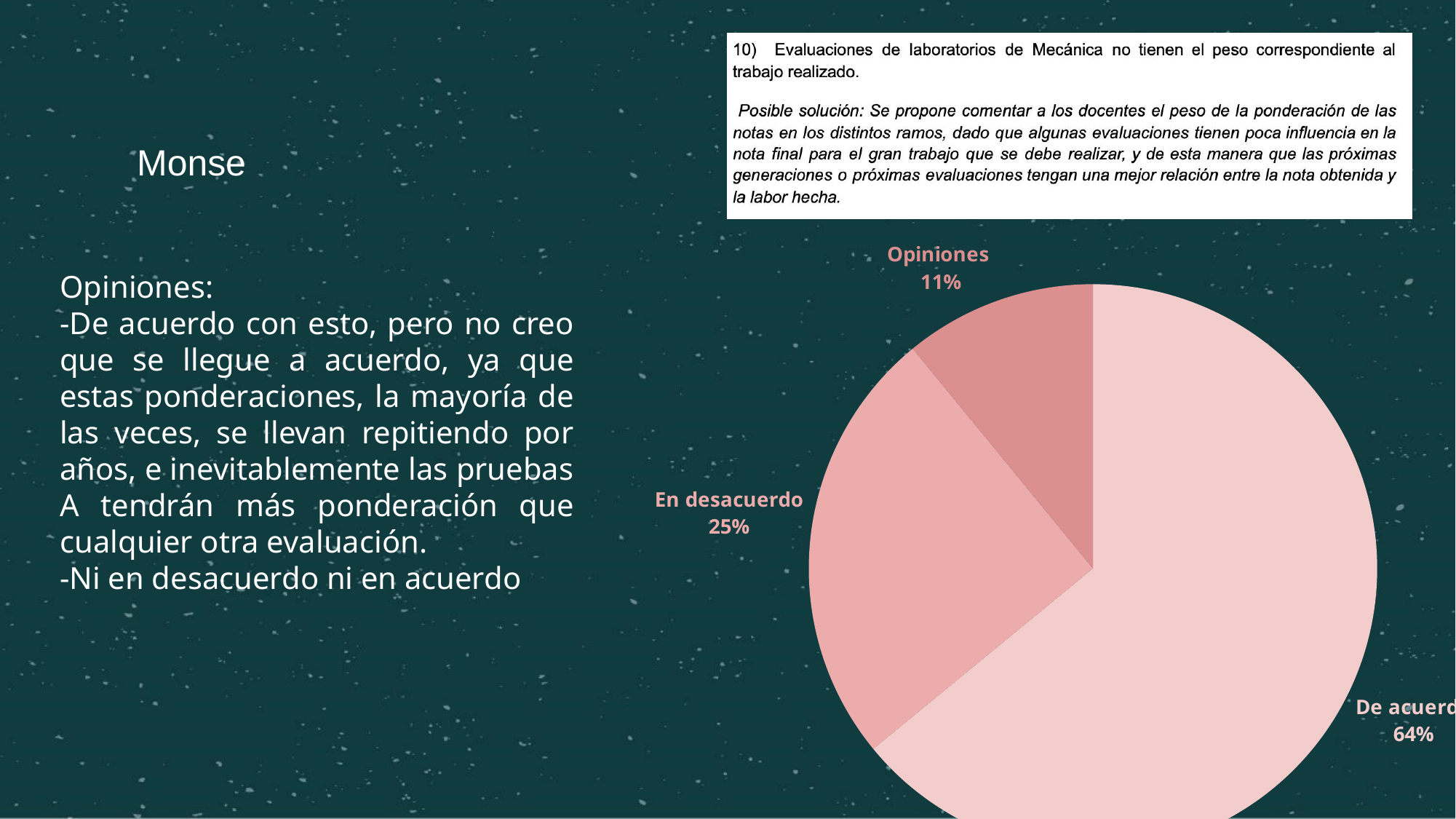
What is the difference in percentage points between the "En desacuerdo" and "Opiniones" slices? 14 What kind of chart is shown on the slide? pie chart What is the difference in percentage points between the "De acuerdo" and "En desacuerdo" slices? 39 Is the "De acuerdo" slice more or less than half of the pie? more Which slice of the pie chart is the smallest? Opiniones What percentage of the pie chart is labelled "En desacuerdo"? 25% How many slices does the pie chart have? 3 What share of the pie does the "De acuerdo" slice represent? 64% Which slice of the pie chart is the largest? De acuerdo What percentage of the pie chart is labelled "Opiniones"? 11% Which slice is larger, "En desacuerdo" or "Opiniones"? En desacuerdo What percentage of the pie chart is labelled "De acuerdo"? 64%